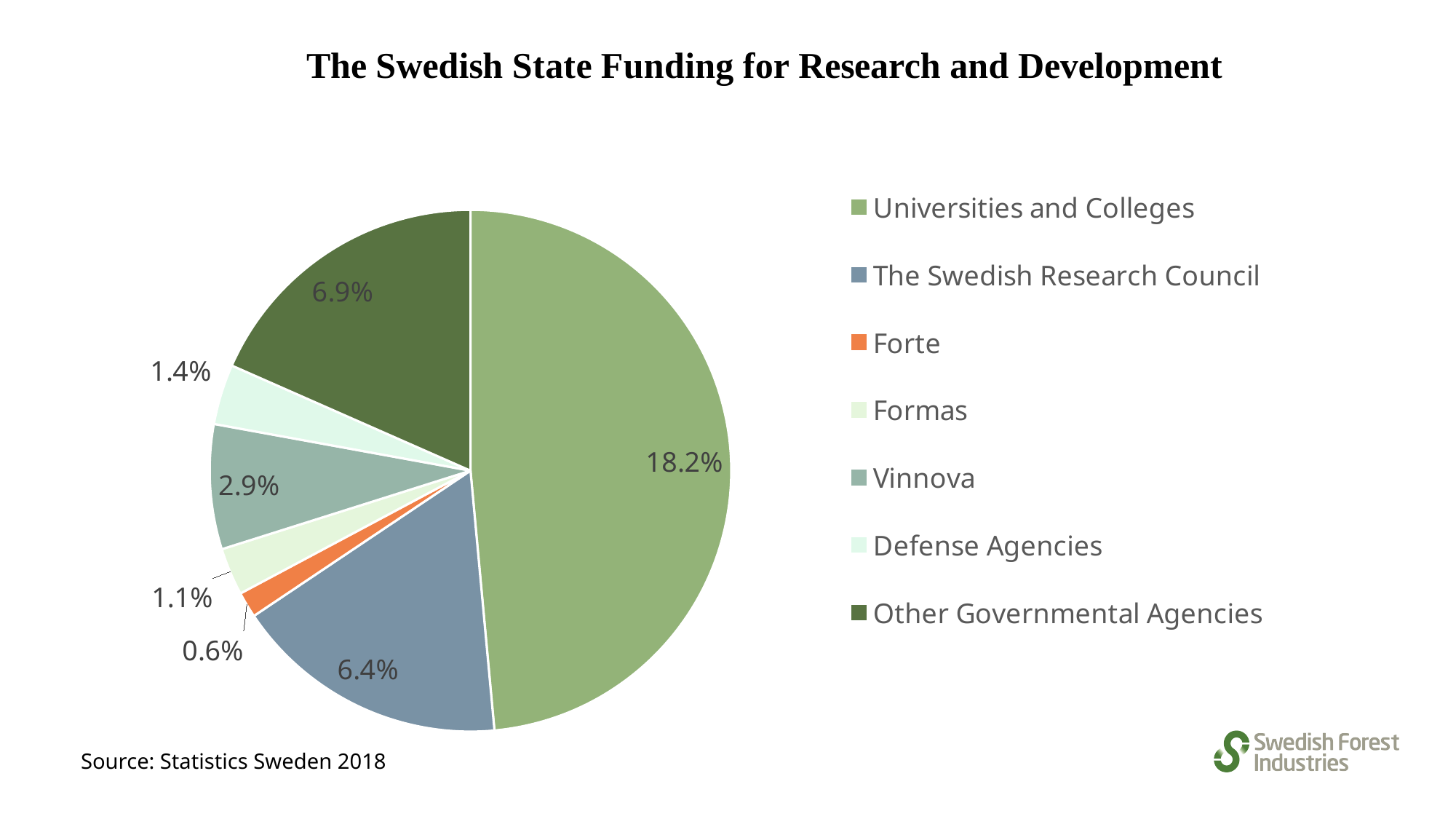
Which is larger, the value for Vinnova or the value for Defense Agencies? Vinnova What is the value shown for Forte? 0.6% What is the title of the chart? The Swedish State Funding for Research and Development What is the value shown for The Swedish Research Council? 6.4% What is the value shown for Other Governmental Agencies? 6.9% What type of chart is shown on the slide? pie chart Which category has the largest slice of the pie? Universities and Colleges What is the difference between the values for Other Governmental Agencies and The Swedish Research Council? 0.5% What is the value shown for Vinnova? 2.9% How many categories does the legend list? 7 Which category has the smallest slice of the pie? Forte What is the value shown for Universities and Colleges? 18.2%